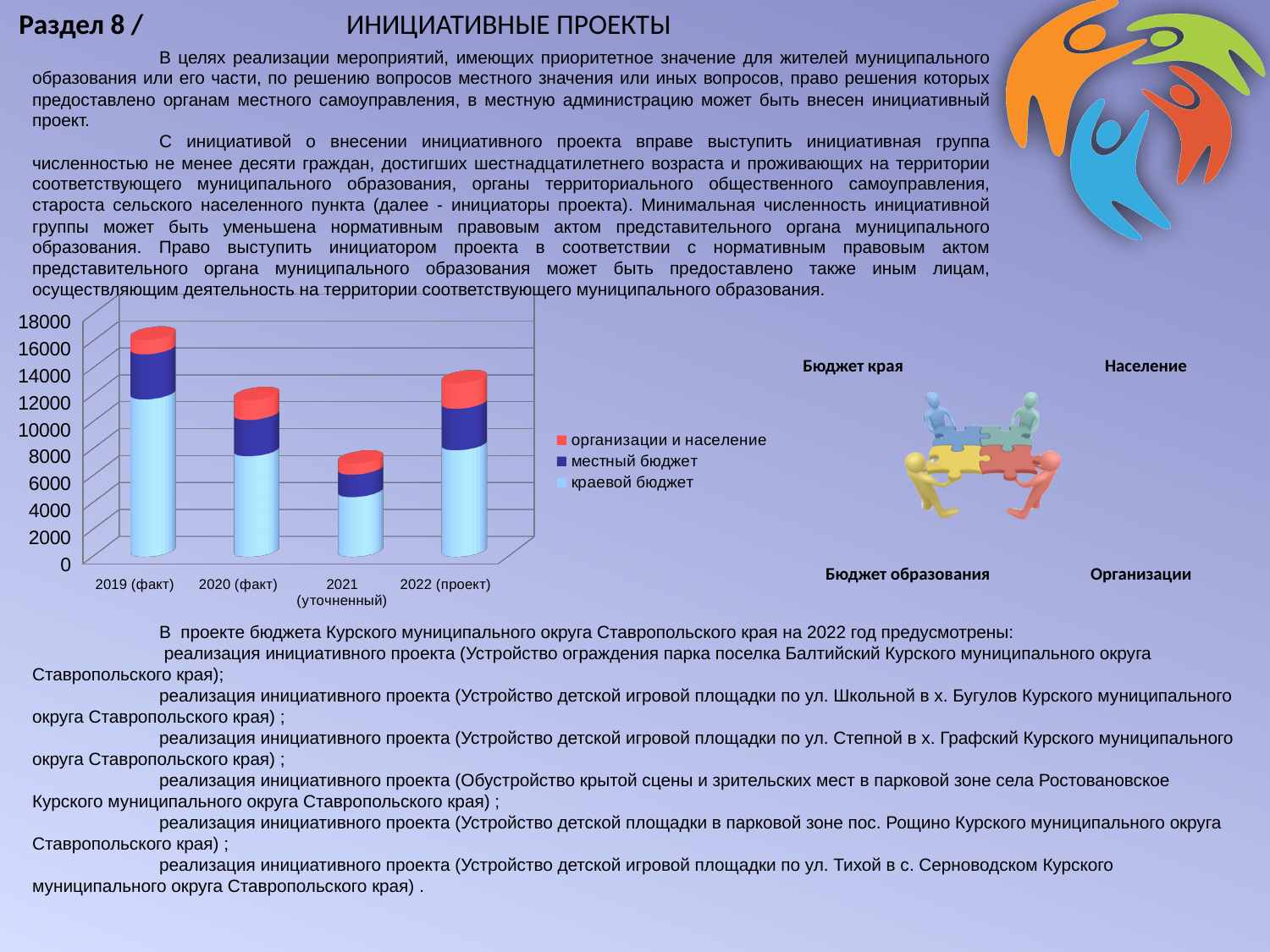
Is the total of the stacked bar for 2021 (уточненный) greater or less than 8000? less Do the stacked bar totals rise or fall from 2019 (факт) to 2021 (уточненный)? fall Which series in the chart legend is shown in red? организации и население Which stacked bar is taller: 2022 (проект) or 2020 (факт)? 2022 (проект) How many series does the chart legend list? 3 Which year has the shortest stacked bar in the chart? 2021 (уточненный) Which stacked bar is taller: 2019 (факт) or 2021 (уточненный)? 2019 (факт) Which year has the tallest stacked bar in the chart? 2019 (факт) What kind of chart is shown on the slide? stacked bar chart How many categories (years) are shown on the x axis of the chart? 4 Is the total of the stacked bar for 2020 (факт) greater or less than 10000? greater